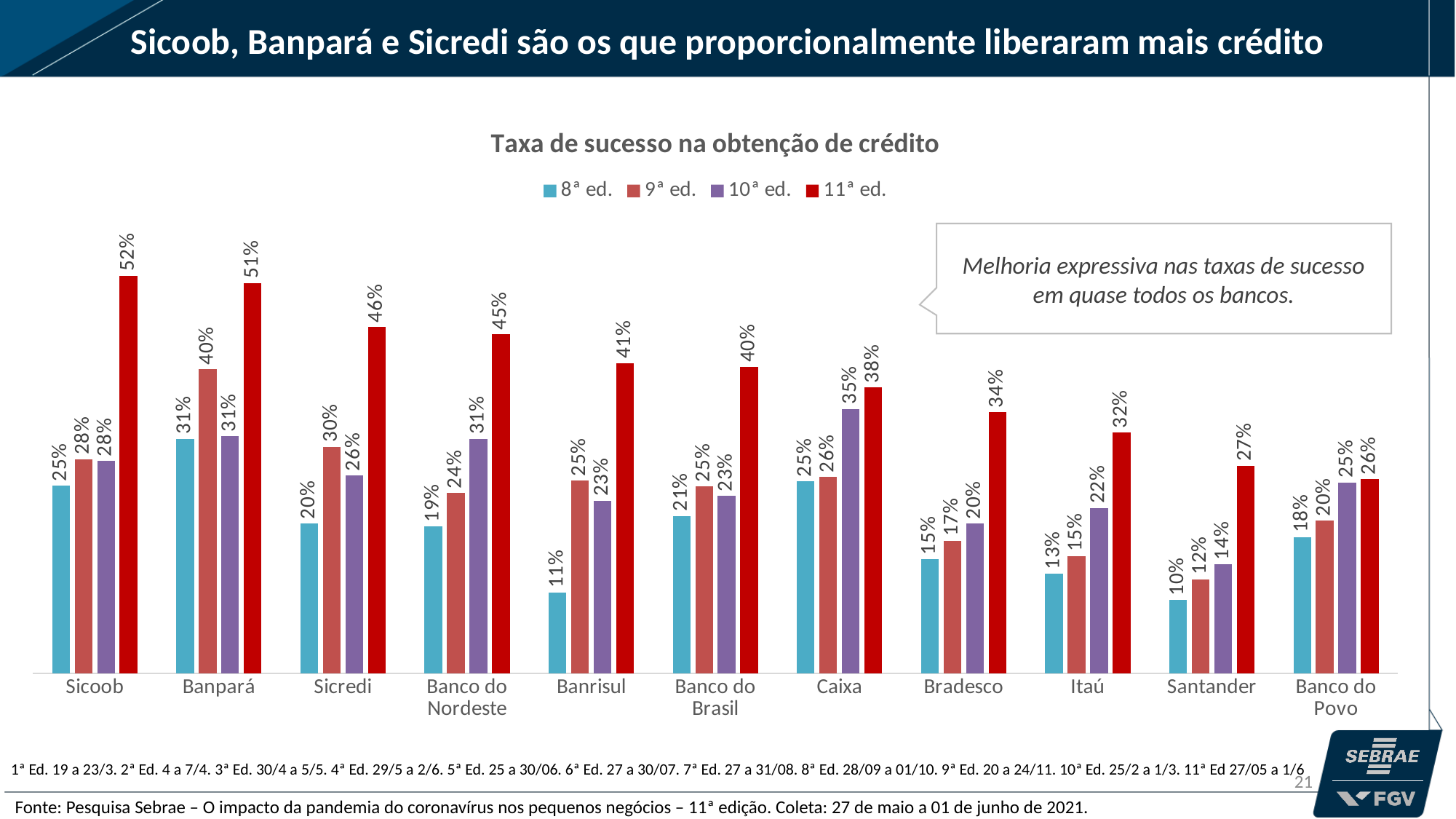
Which is larger: the 9ª ed. value for Banpará or the 9ª ed. value for Sicredi? Banpará What kind of chart is shown on the slide? Bar chart What is the title of the chart? Taxa de sucesso na obtenção de crédito What is the value for Caixa in the 10ª ed. series? 35% Which bank has the lowest value in the 8ª ed. series? Santander What is the value for Banrisul in the 8ª ed. series? 11% Which bank has the highest value in the 11ª ed. series? Sicoob How many series does the legend list? 4 What is the difference between the 11ª ed. and 8ª ed. values for Banrisul? 30 percentage points What is the value for Sicoob in the 11ª ed. series? 52% How many banks are shown on the x axis? 11 What is the difference between the 11ª ed. values for Sicoob and Banco do Povo? 26 percentage points